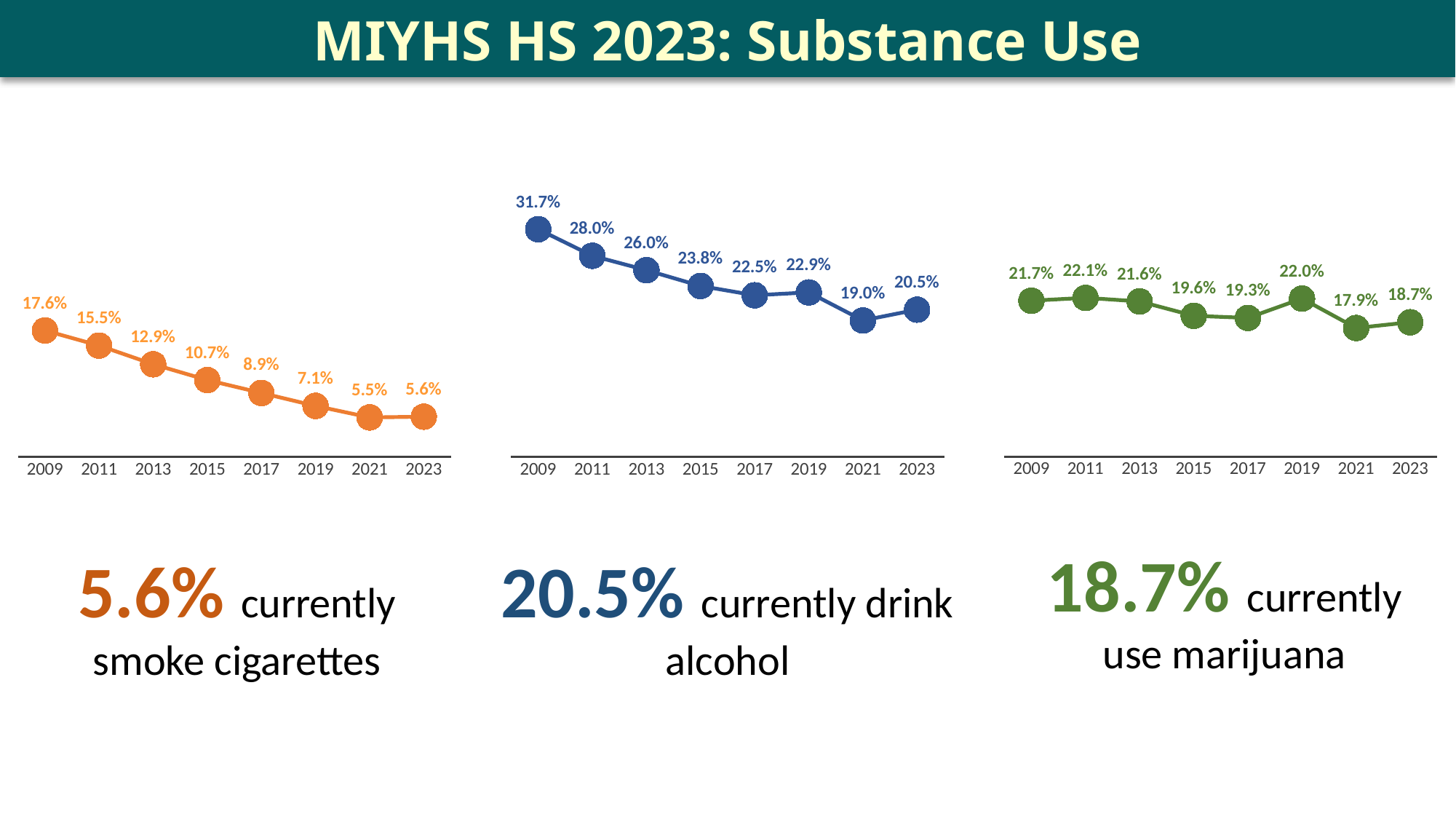
In the middle chart (alcohol), what is the value for 2015? 23.8% What kind of chart is the middle chart (alcohol)? Line chart In the middle chart (alcohol), which year has the highest value? 2009 In the middle chart (alcohol), what is the difference between the 2009 value and the 2023 value? 11.2% In the left chart (cigarette smoking), which year has the lowest value? 2021 What colour is the line in the right chart (marijuana)? Green In the left chart (cigarette smoking), what is the value for 2009? 17.6% In the right chart (marijuana), what is the value for 2021? 17.9% How many years are plotted in the left chart (cigarette smoking)? 8 In the right chart (marijuana), which is larger, the value for 2019 or the value for 2017? 2019 In the right chart (marijuana), which year has the lowest value? 2021 In the left chart (cigarette smoking), do the values generally rise or fall from 2009 to 2023? Fall